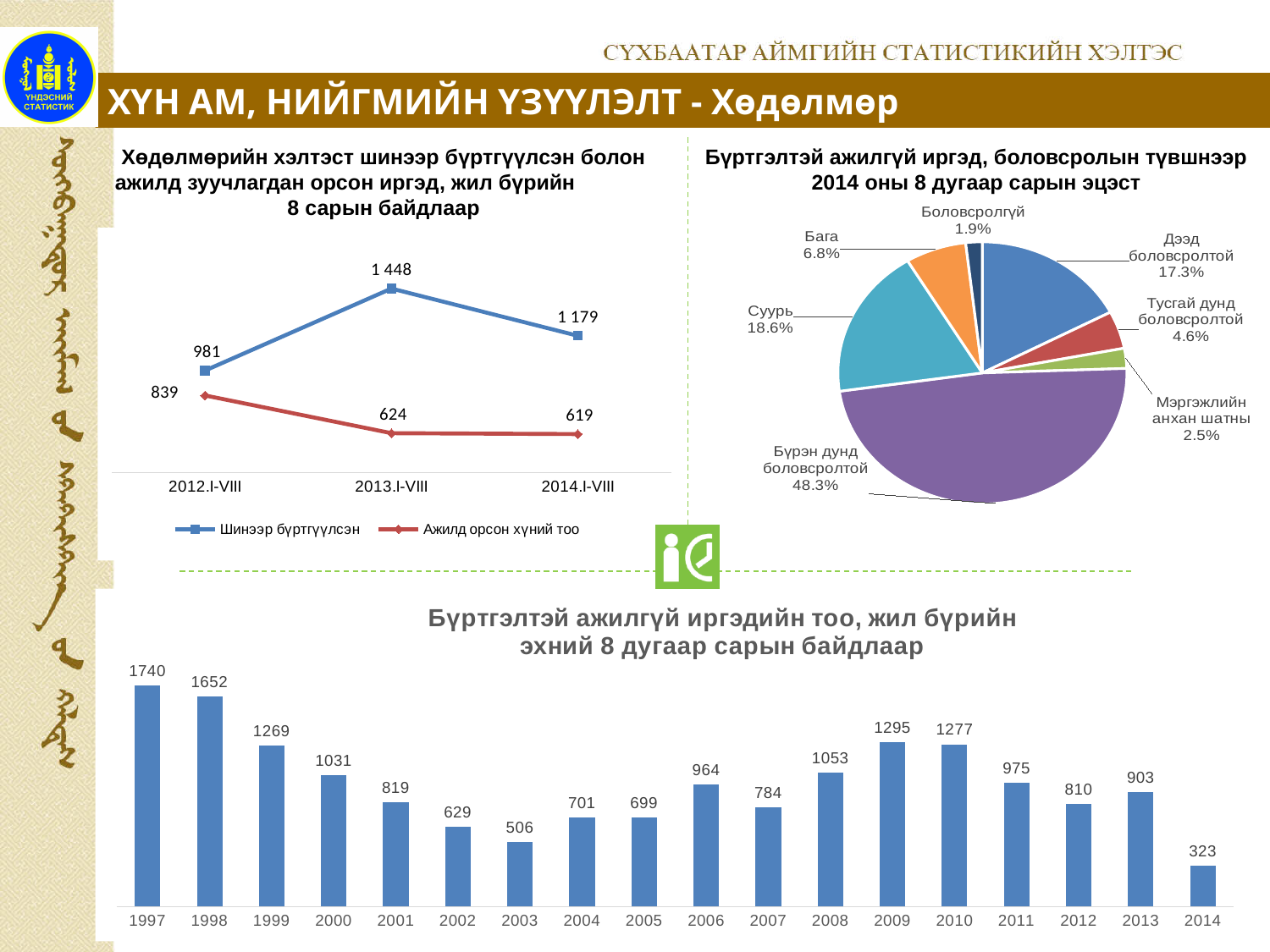
In the bottom chart (Бүртгэлтэй ажилгүй иргэдийн тоо), how many years are shown on the x axis? 18 In the bottom chart (Бүртгэлтэй ажилгүй иргэдийн тоо), what is the difference between the values for 2013 and 2014? 580 In the top-left line chart, does the Ажилд орсон хүний тоо series rise or fall from 2012.I-VIII to 2014.I-VIII? Fall What kind of chart is the bottom chart (Бүртгэлтэй ажилгүй иргэдийн тоо)? Bar chart In the bottom chart (Бүртгэлтэй ажилгүй иргэдийн тоо), which year has the highest value? 1997 In the top-right pie chart, which is larger: Суурь or Дээд боловсролтой? Суурь In the bottom chart (Бүртгэлтэй ажилгүй иргэдийн тоо), what is the value for 2009? 1295 In the top-left line chart, what is the value of Ажилд орсон хүний тоо for 2012.I-VIII? 839 In the top-right pie chart, what share is Бүрэн дунд боловсролтой? 48.3% In the top-left line chart, how many series does the legend list? 2 In the bottom chart (Бүртгэлтэй ажилгүй иргэдийн тоо), which year has the lowest value? 2014 In the top-left line chart, what is the value of Шинээр бүртгүүлсэн for 2013.I-VIII? 1 448